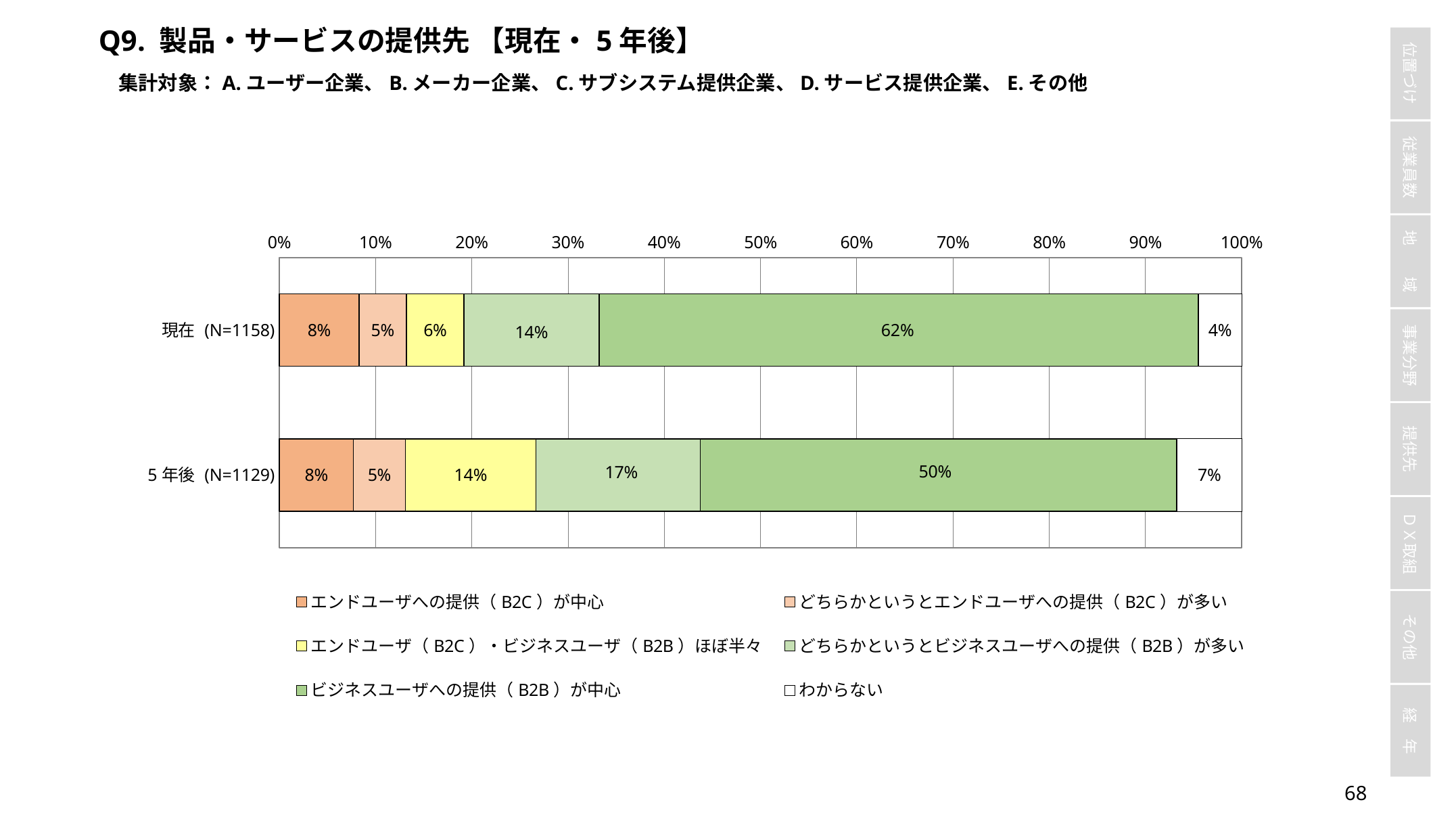
How many categories (bars) are plotted in the chart? 2 What is the value for エンドユーザ（B2C）・ビジネスユーザ（B2B）ほぼ半々 in the 5年後 (N=1129) bar? 14% How many series does the legend list? 6 What is the value for ビジネスユーザへの提供（B2B）が中心 in the 5年後 (N=1129) bar? 50% What is the value for わからない in the 現在 (N=1158) bar? 4% Which is larger: どちらかというとビジネスユーザへの提供（B2B）が多い for 現在 or for 5年後? 5年後 Which segment is the largest in the 現在 (N=1158) bar? ビジネスユーザへの提供（B2B）が中心 What is the value for ビジネスユーザへの提供（B2B）が中心 in the 現在 (N=1158) bar? 62% What type of chart is shown on the slide? stacked bar chart What is the difference between the わからない values for 5年後 and 現在? 3% What is the sample size (N) shown for the 現在 category? N=1158 What is the difference between the ビジネスユーザへの提供（B2B）が中心 values for 現在 and 5年後? 12%